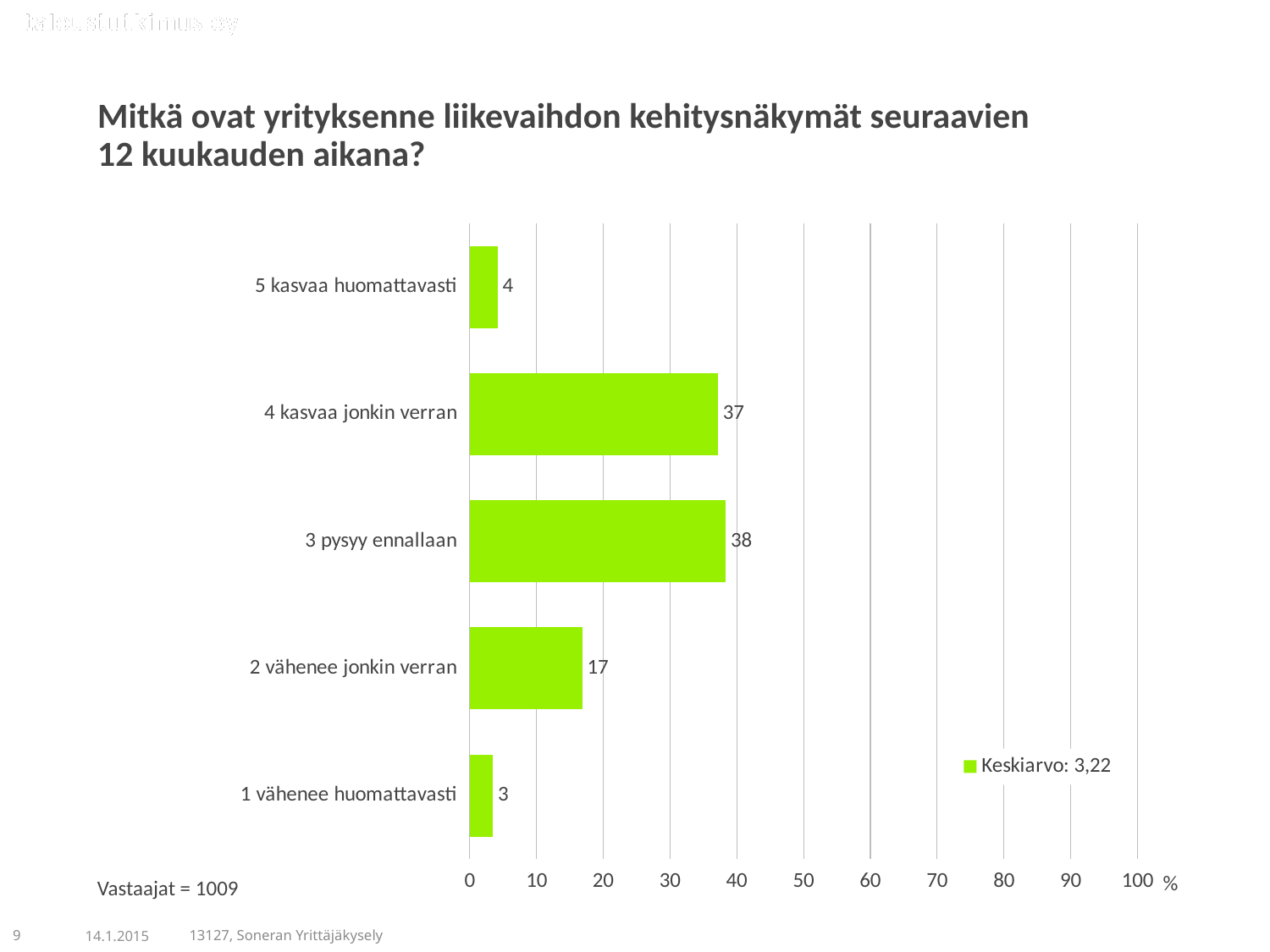
How many respondents (Vastaajat) are stated on the slide? 1009 How many categories are shown in the chart? 5 What is the difference between the values for "3 pysyy ennallaan" and "2 vähenee jonkin verran"? 21 What is the value for "1 vähenee huomattavasti"? 3 What kind of chart is shown on the slide? bar chart Which is larger, the value for "5 kasvaa huomattavasti" or the value for "2 vähenee jonkin verran"? 2 vähenee jonkin verran Is the value for "4 kasvaa jonkin verran" greater or less than 30? greater Which category has the highest value? 3 pysyy ennallaan What is the value for "2 vähenee jonkin verran"? 17 Which category has the lowest value? 1 vähenee huomattavasti What is the value for "4 kasvaa jonkin verran"? 37 What does the legend entry say? Keskiarvo: 3,22